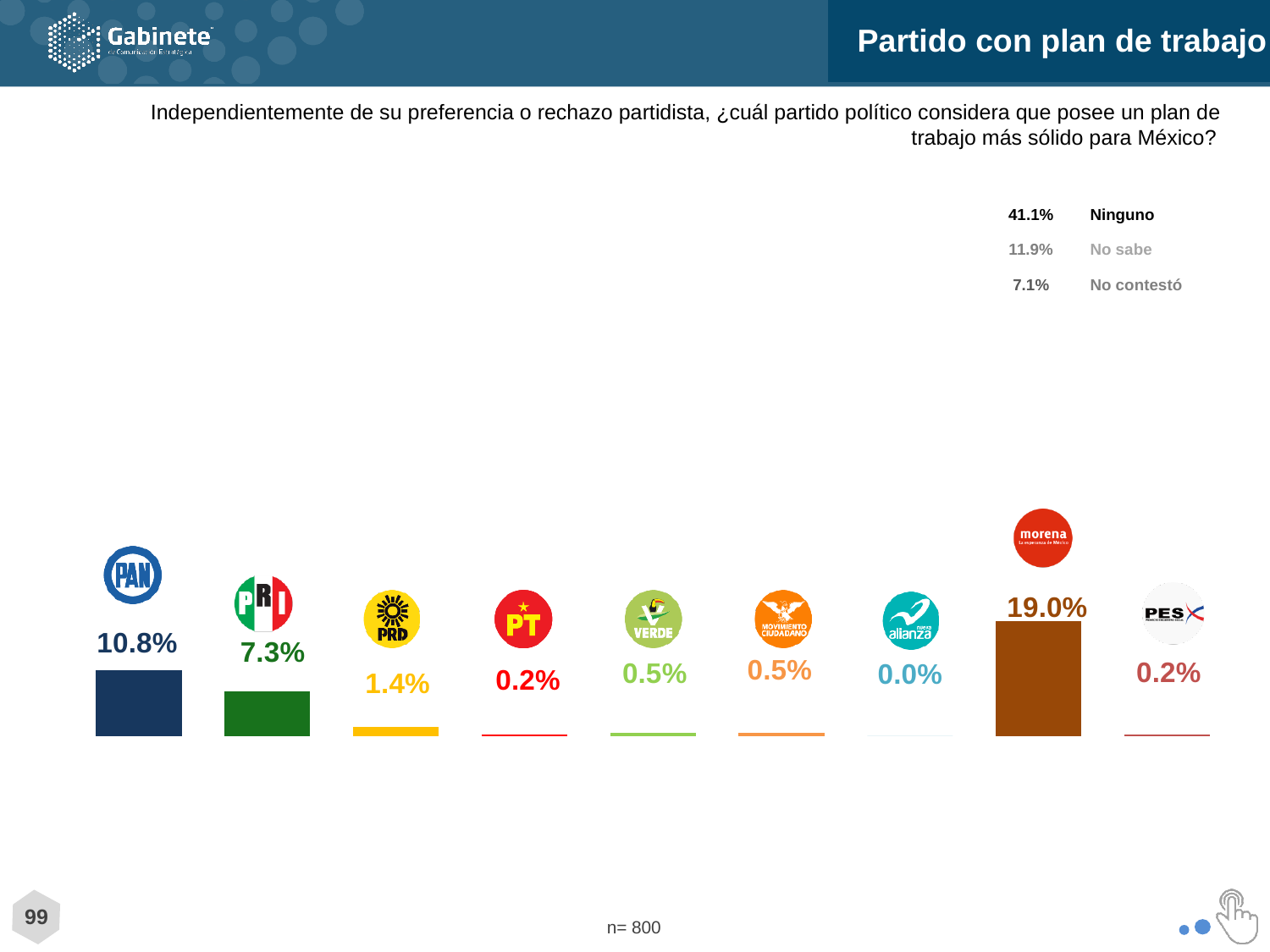
Which party has the highest value in the chart? Morena What is the value shown for Nueva Alianza? 0.0% What is the value shown for PAN? 10.8% What kind of chart is shown on the slide? Bar chart How many parties are shown in the bar chart? 9 What is the value shown for PRI? 7.3% Which party has the lowest value in the chart? Nueva Alianza What percentage of respondents chose Morena as the party with the most solid work plan? 19.0% Which is larger, the value for PRD or the value for PT? PRD What is the difference between the values for PAN and PRI? 3.5% What is the difference between the values for Morena and PAN? 8.2% What is the value shown for PRD? 1.4%